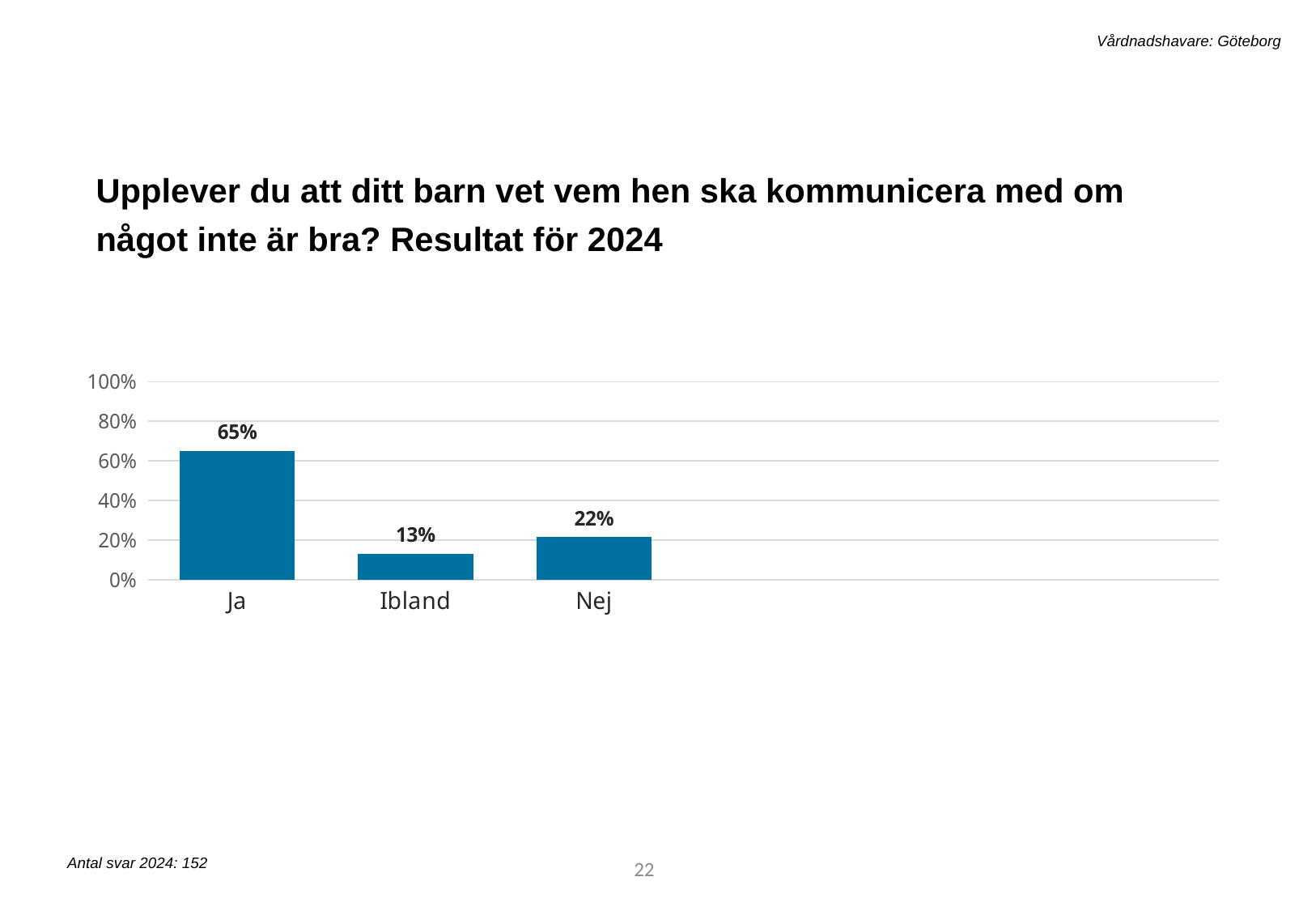
What kind of chart is shown on the slide? bar chart What is the value for Nej? 22% Which is larger, the value for Ibland or the value for Nej? Nej Which category has the highest value? Ja What is the difference between the values for Ja and Nej? 43% What is the value for Ibland? 13% What is the value for Ja? 65% How many categories are shown on the x axis? 3 Which category has the lowest value? Ibland Is the value for Ja greater or less than 60%? greater What is the difference between the values for Nej and Ibland? 9% What is the number of responses (Antal svar) for 2024 stated on the slide? 152